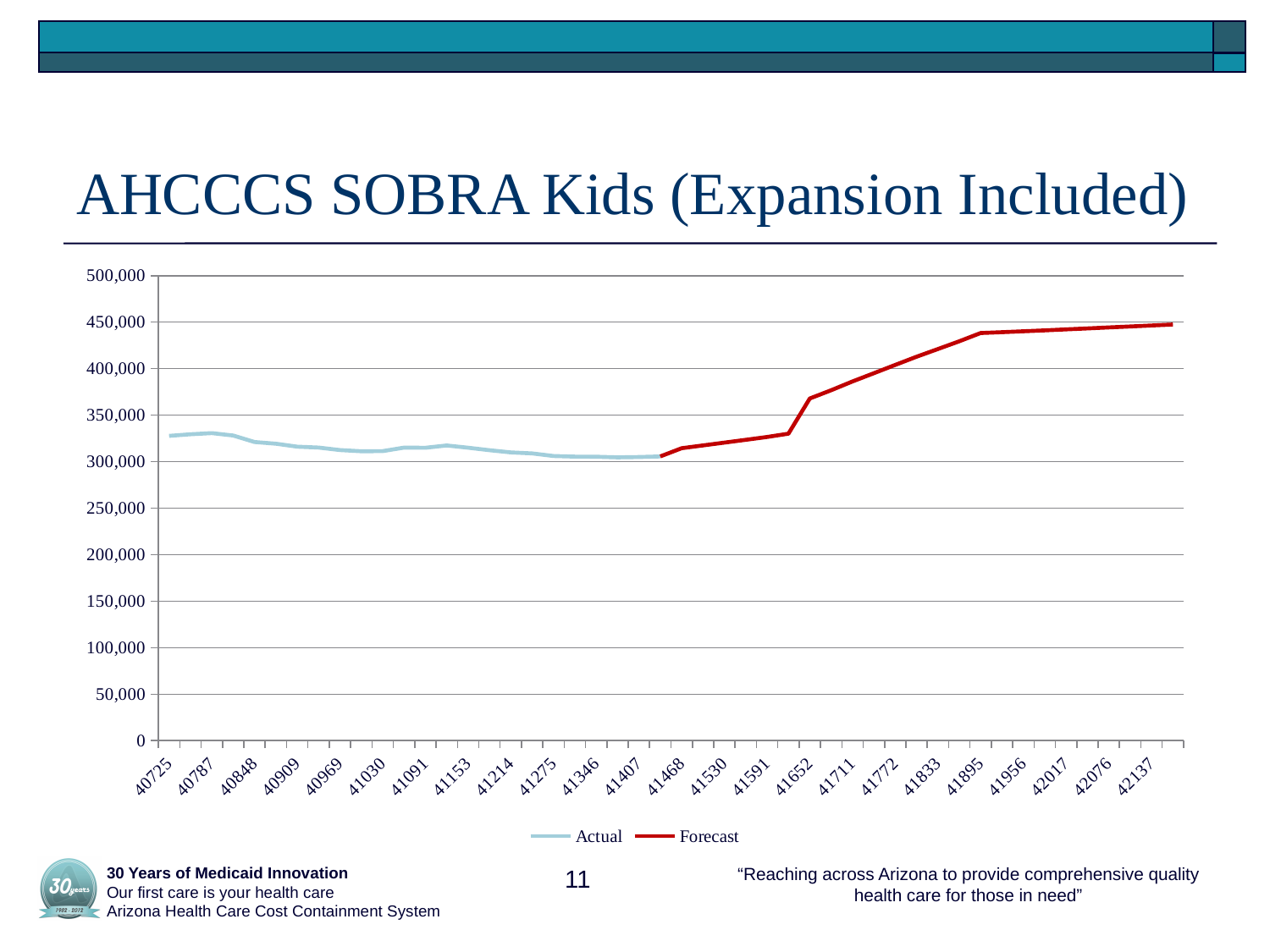
Is the value at 41895 greater or less than 400,000? greater Is the value at 40725 greater or less than 300,000? greater What kind of chart is shown on the slide? line chart Is the value at 42137 greater or less than 400,000? greater What is the title of the chart? AHCCCS SOBRA Kids (Expansion Included) Which is larger, the value at 42137 or the value at 40725? 42137 How many series does the legend list? 2 Which series reaches the highest value on the chart? Forecast What are the two series named in the legend? Actual and Forecast Does the Forecast series rise or fall along the x axis? rise